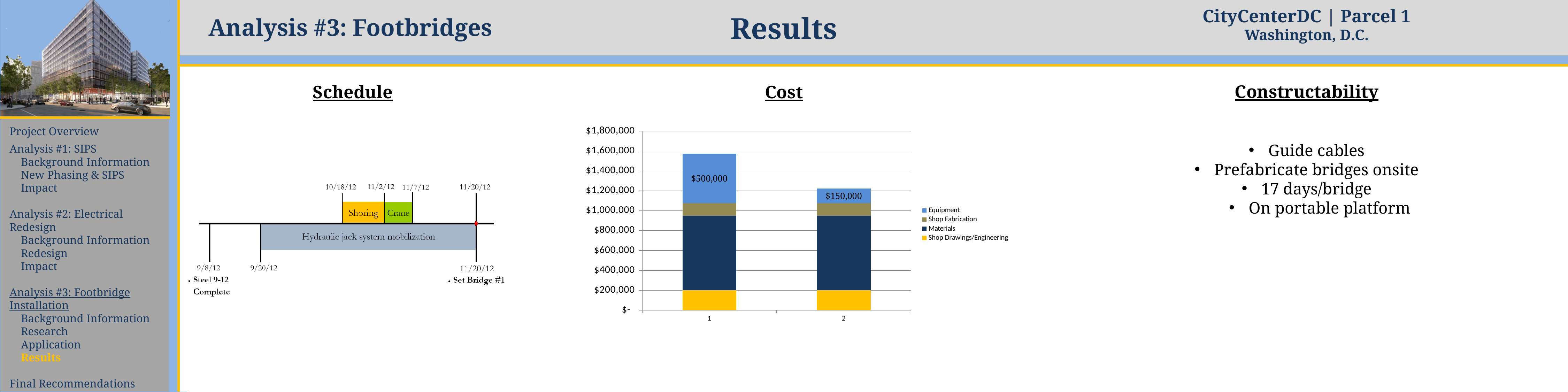
In the Cost chart, what is the Equipment value for category 1? $500,000 How many bars (categories) are plotted in the Cost chart? 2 In the Cost chart, which series is shown in yellow at the bottom of each bar? Shop Drawings/Engineering In the Cost chart, is the total for category 2 greater or less than $1,400,000? less In the Cost chart, what is the Equipment value for category 2? $150,000 What kind of chart is the Cost chart? bar chart What is the title above the bar chart on the slide? Cost How many series does the legend of the Cost chart list? 4 In the Cost chart, what is the difference between the Equipment values for category 1 and category 2? $350,000 In the Cost chart, which category has the highest total stacked bar? 1 In the Cost chart, is the total for category 1 greater or less than $1,400,000? greater In the Cost chart, which category has the larger Equipment value, 1 or 2? 1